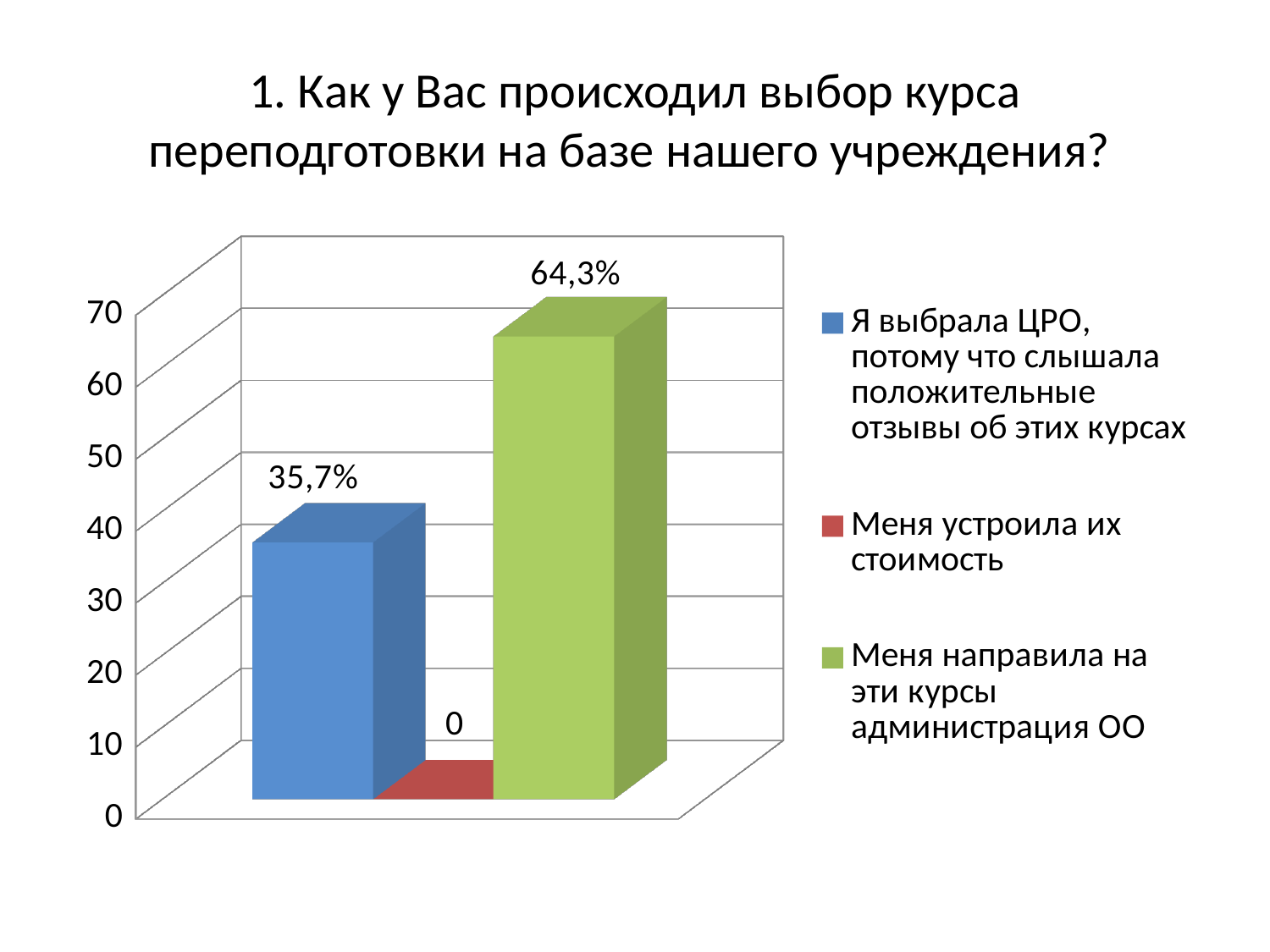
Which response has the lowest value? Меня устроила их стоимость Is the value for "Меня направила на эти курсы администрация ОО" greater or less than 60? greater Is the value for "Я выбрала ЦРО, потому что слышала положительные отзывы об этих курсах" greater or less than 40? less What is the difference between the values for "Меня направила на эти курсы администрация ОО" and "Я выбрала ЦРО, потому что слышала положительные отзывы об этих курсах"? 28,6% What colour is the bar for "Меня устроила их стоимость"? Red Which is larger: the value for "Я выбрала ЦРО, потому что слышала положительные отзывы об этих курсах" or for "Меня направила на эти курсы администрация ОО"? Меня направила на эти курсы администрация ОО What value is shown for "Я выбрала ЦРО, потому что слышала положительные отзывы об этих курсах"? 35,7% Which response has the highest value? Меня направила на эти курсы администрация ОО How many series does the legend list? 3 What kind of chart is shown on the slide? Bar chart What value is shown for "Меня устроила их стоимость"? 0 What value is shown for "Меня направила на эти курсы администрация ОО"? 64,3%